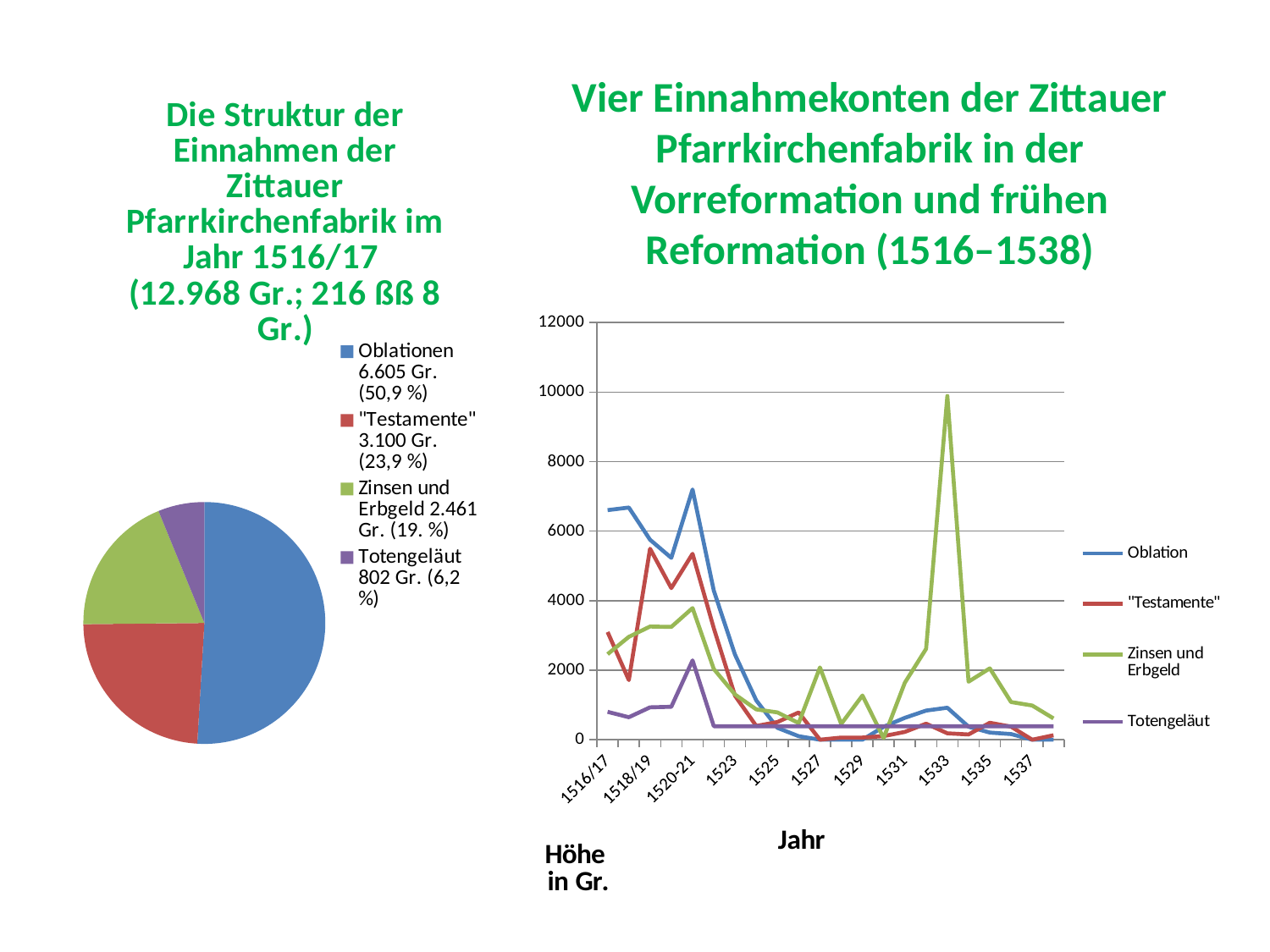
In the pie chart on the left, which category has the smallest share? Totengeläut In the line chart on the right, is the value for Oblation in 1516/17 greater or less than 6000? greater How many slices does the pie chart on the left have? 4 How many series does the legend of the line chart on the right list? 4 What kind of chart is the chart on the right, titled 'Vier Einnahmekonten der Zittauer Pfarrkirchenfabrik'? line chart In the pie chart on the left, what value is shown for Totengeläut? 802 Gr. (6,2 %) In the line chart on the right, which series has the highest value in 1533? Zinsen und Erbgeld In the pie chart on the left, what is the difference in Gr. between "Testamente" and Zinsen und Erbgeld? 639 Gr. In the pie chart on the left, which category has the largest share? Oblationen In the pie chart on the left, what percentage share does "Testamente" have? 23,9 % In the pie chart on the left, what value is shown for Oblationen? 6.605 Gr. (50,9 %) In the line chart on the right, is the value for Zinsen und Erbgeld in 1533 greater or less than 8000? greater